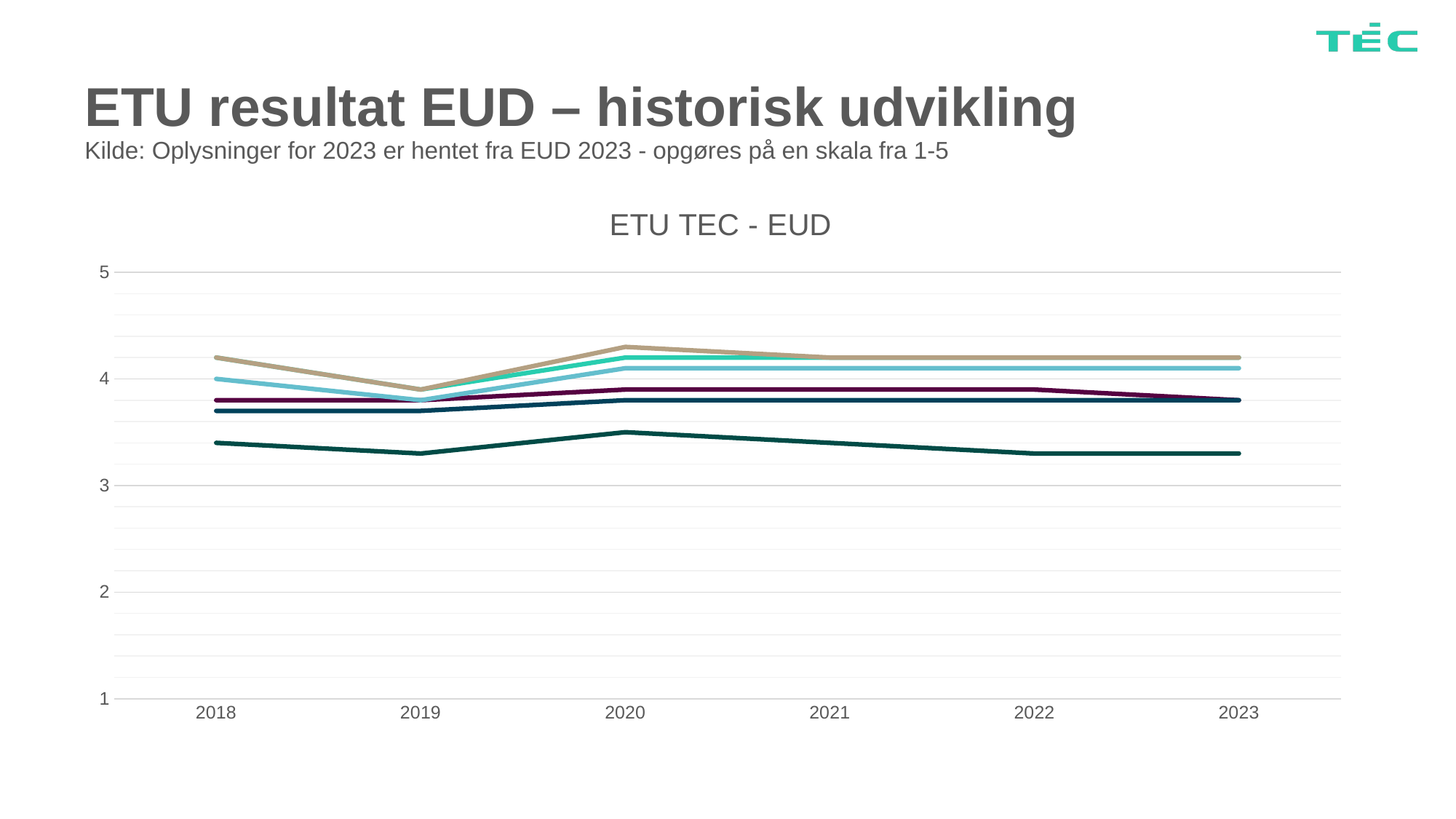
What is the title of the chart? ETU TEC - EUD How many years are shown on the x axis of the chart? 6 Does the highest line (tan) rise or fall from 2019 to 2020? rise Are any of the lines above 5 at any point? no Is the value of the highest line (tan) in 2020 greater or less than 4? greater Is the value of the lowest line (dark green) in 2019 greater or less than 4? less What is the first year shown on the x axis? 2018 How many lines are plotted in the chart? 6 In 2020, which line is higher: the tan line or the dark green line? the tan line Does the lowest line (dark green) rise or fall from 2018 to 2019? fall What kind of chart is shown on the slide? line chart